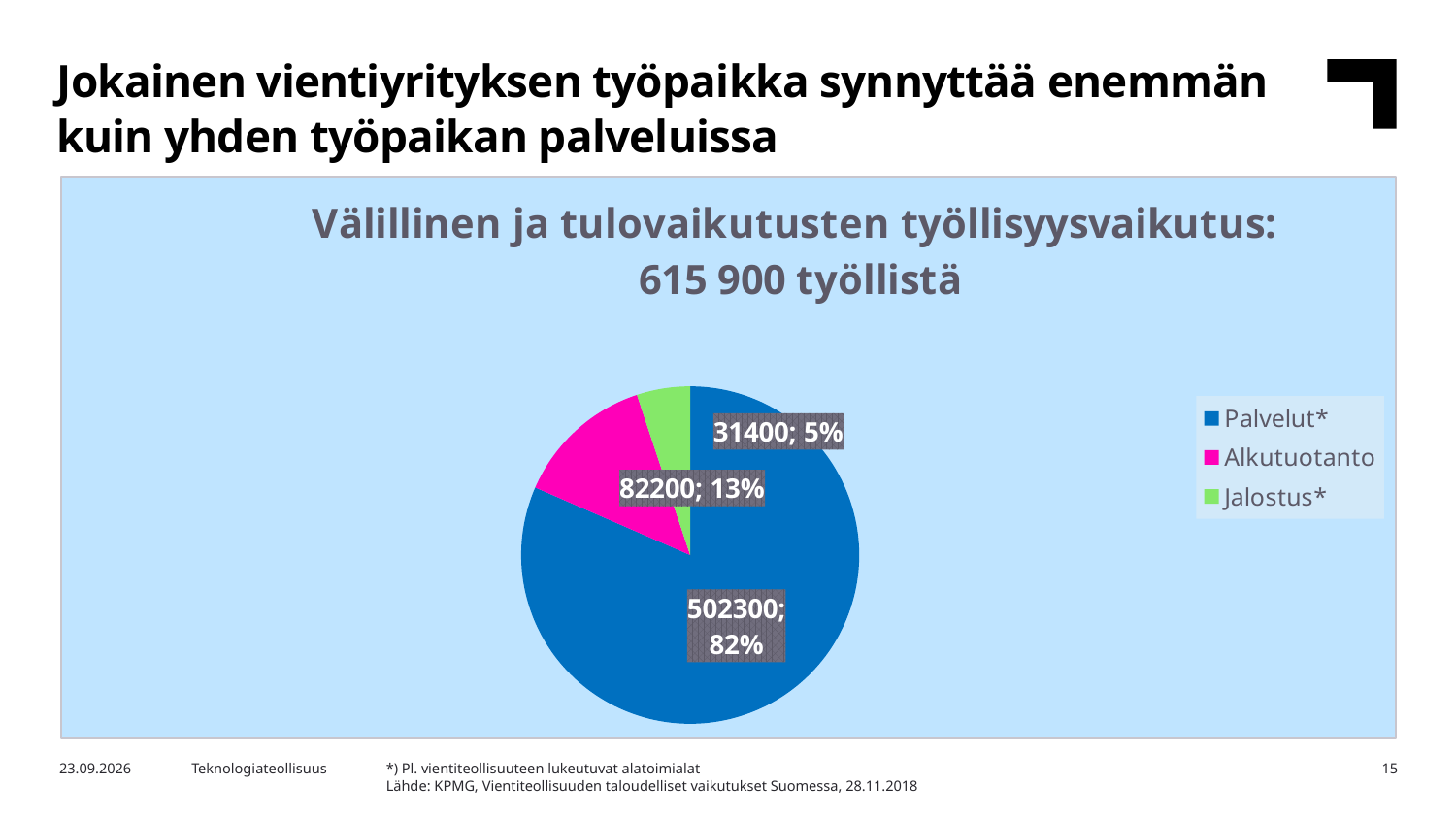
What is the value for Palvelut* in the pie chart? 502300 What is the difference between the values for Alkutuotanto and Jalostus*? 50800 What share of the pie does Palvelut* represent? 82% What share of the pie does Jalostus* represent? 5% How many categories does the pie chart show? 3 What is the value for Jalostus* in the pie chart? 31400 What share of the pie does Alkutuotanto represent? 13% What kind of chart is shown on the slide? pie chart What is the title of the pie chart? Välillinen ja tulovaikutusten työllisyysvaikutus: 615 900 työllistä What is the value for Alkutuotanto in the pie chart? 82200 Which category has the largest slice in the pie chart? Palvelut* Which category has the smallest slice in the pie chart? Jalostus*